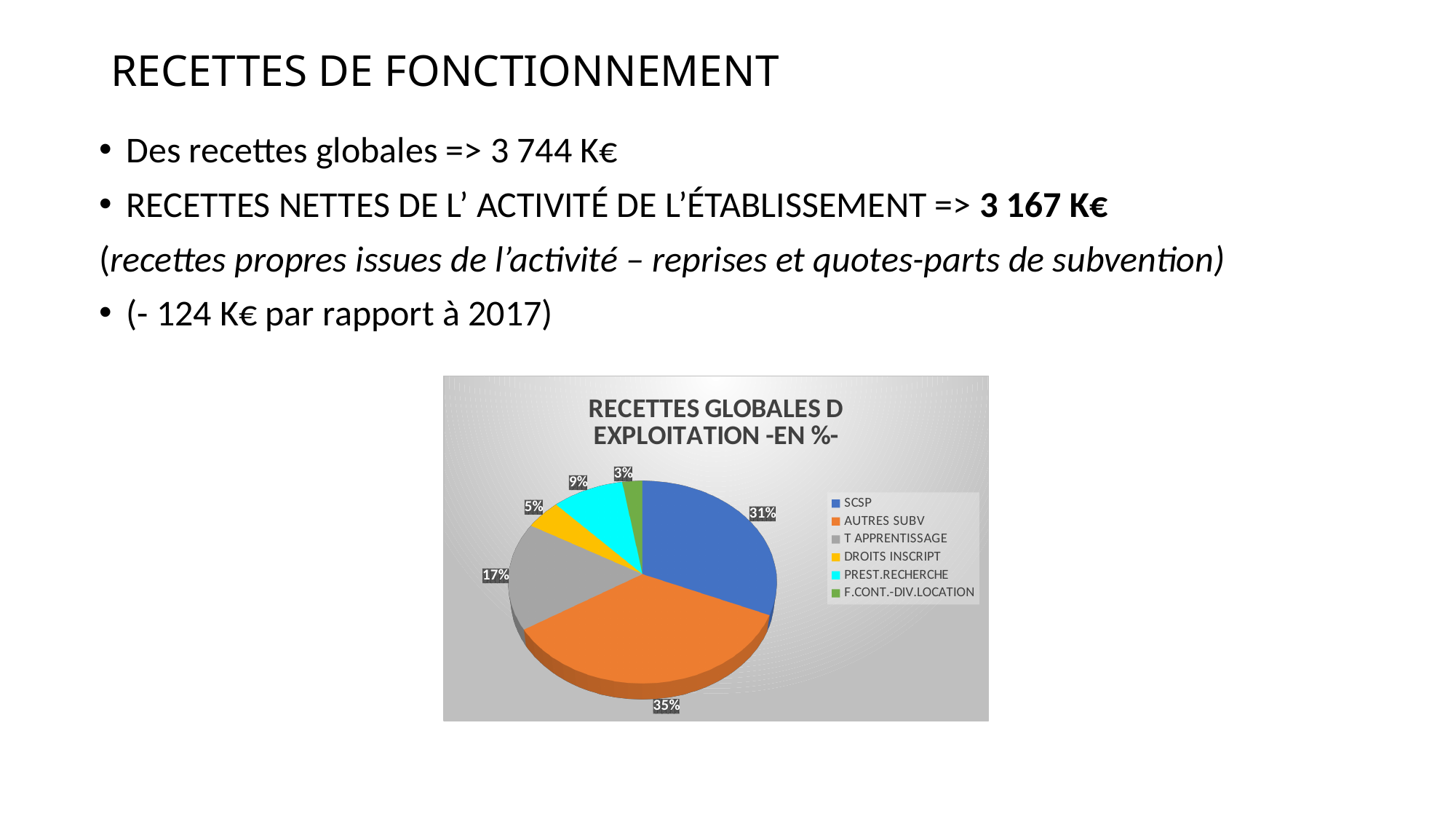
What share of the pie does SCSP represent? 31% What share of the pie does AUTRES SUBV represent? 35% Which category has the smallest share of the pie? F.CONT.-DIV.LOCATION What is the difference in percentage points between the AUTRES SUBV share and the SCSP share? 4 What is the title of the chart? RECETTES GLOBALES D EXPLOITATION -EN %- What share of the pie does DROITS INSCRIPT represent? 5% What kind of chart is shown on the slide? Pie chart Which category has the largest share of the pie? AUTRES SUBV How many categories does the legend list? 6